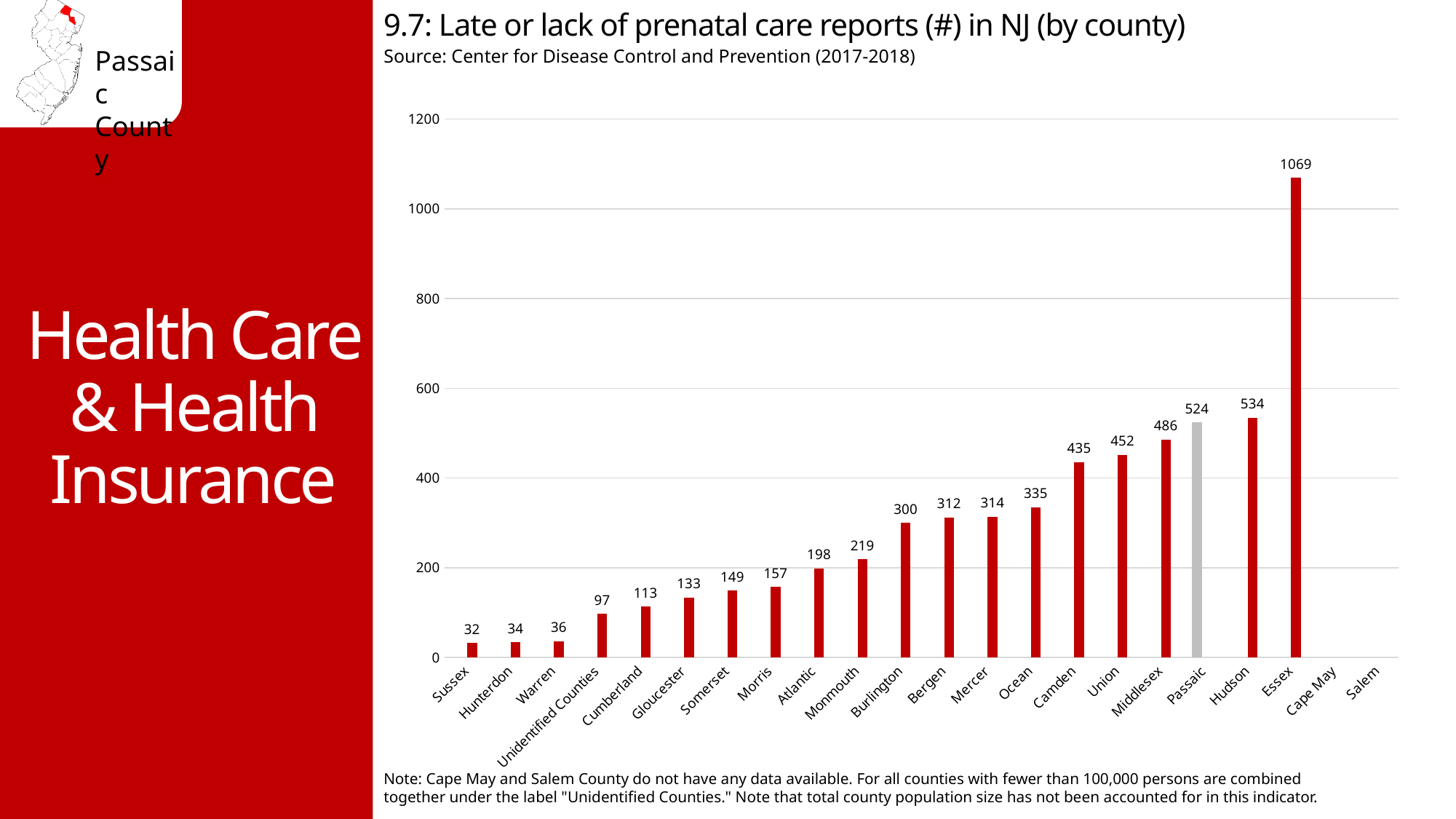
What is the difference between the values for Hudson and Passaic? 10 Which has a larger value, Camden or Ocean? Camden What kind of chart is shown on the slide? Bar chart How many county labels are shown on the x axis? 22 What is the difference between the values for Essex and Middlesex? 583 What is the number of late or lack of prenatal care reports for Passaic County? 524 Which county has the highest number of late or lack of prenatal care reports? Essex What is the value shown for Cumberland County? 113 Which county has the lowest number of late or lack of prenatal care reports? Sussex Is the value for Union greater or less than 400? greater Which bar is coloured grey instead of red? Passaic What is the value shown for Essex County? 1069